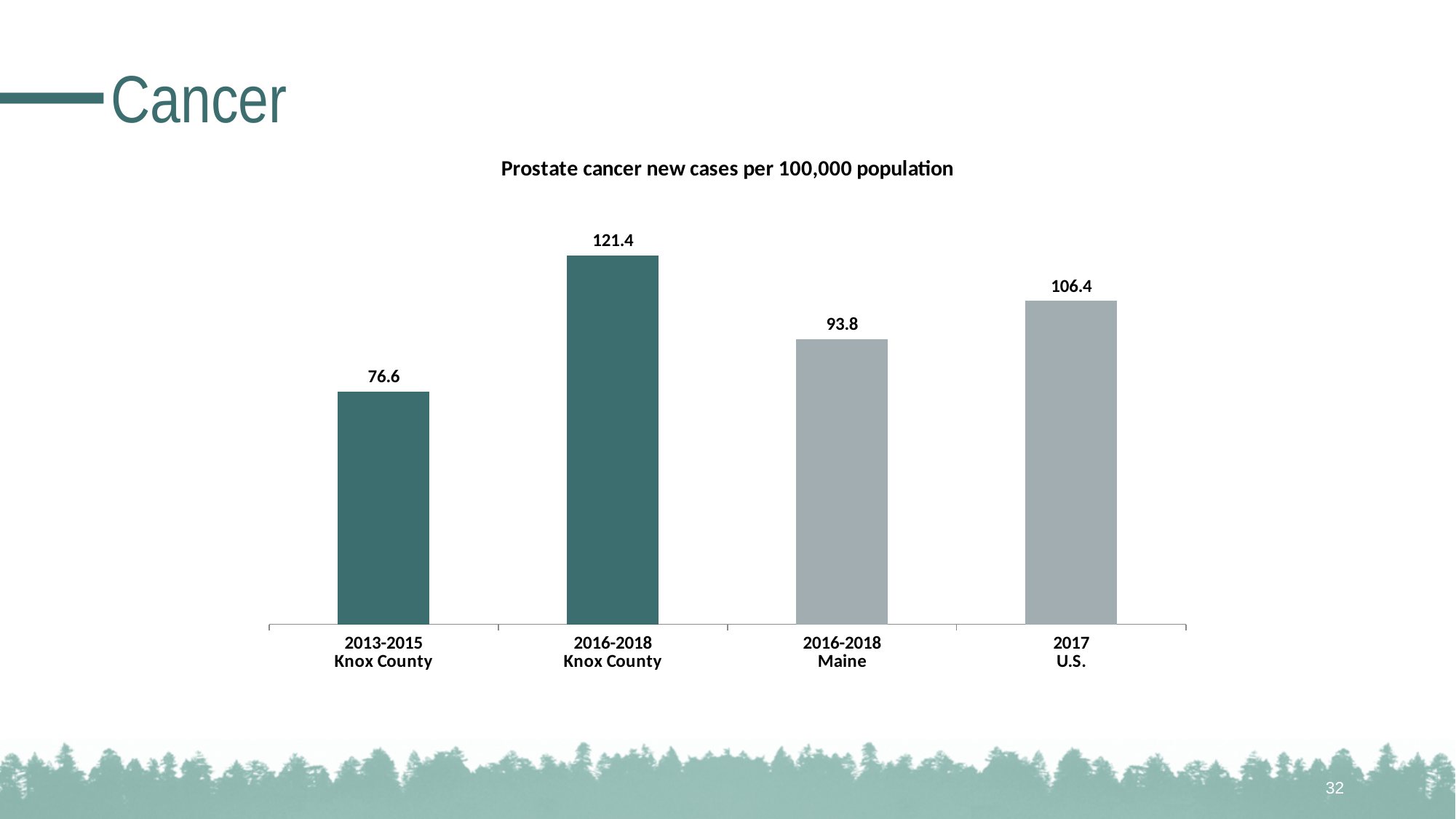
What is the difference between the 2017 U.S. value and the 2016-2018 Maine value? 12.6 How many bars are shown in the chart? 4 What is the value for 2017 U.S.? 106.4 What is the difference between the 2016-2018 Knox County value and the 2013-2015 Knox County value? 44.8 What is the value for 2016-2018 Knox County? 121.4 What is the title of the chart? Prostate cancer new cases per 100,000 population What is the value for 2016-2018 Maine? 93.8 Which category has the highest value? 2016-2018 Knox County What is the value for 2013-2015 Knox County? 76.6 Which is larger, the value for 2016-2018 Maine or the value for 2017 U.S.? 2017 U.S. Which category has the lowest value? 2013-2015 Knox County What kind of chart is shown on the slide? Bar chart